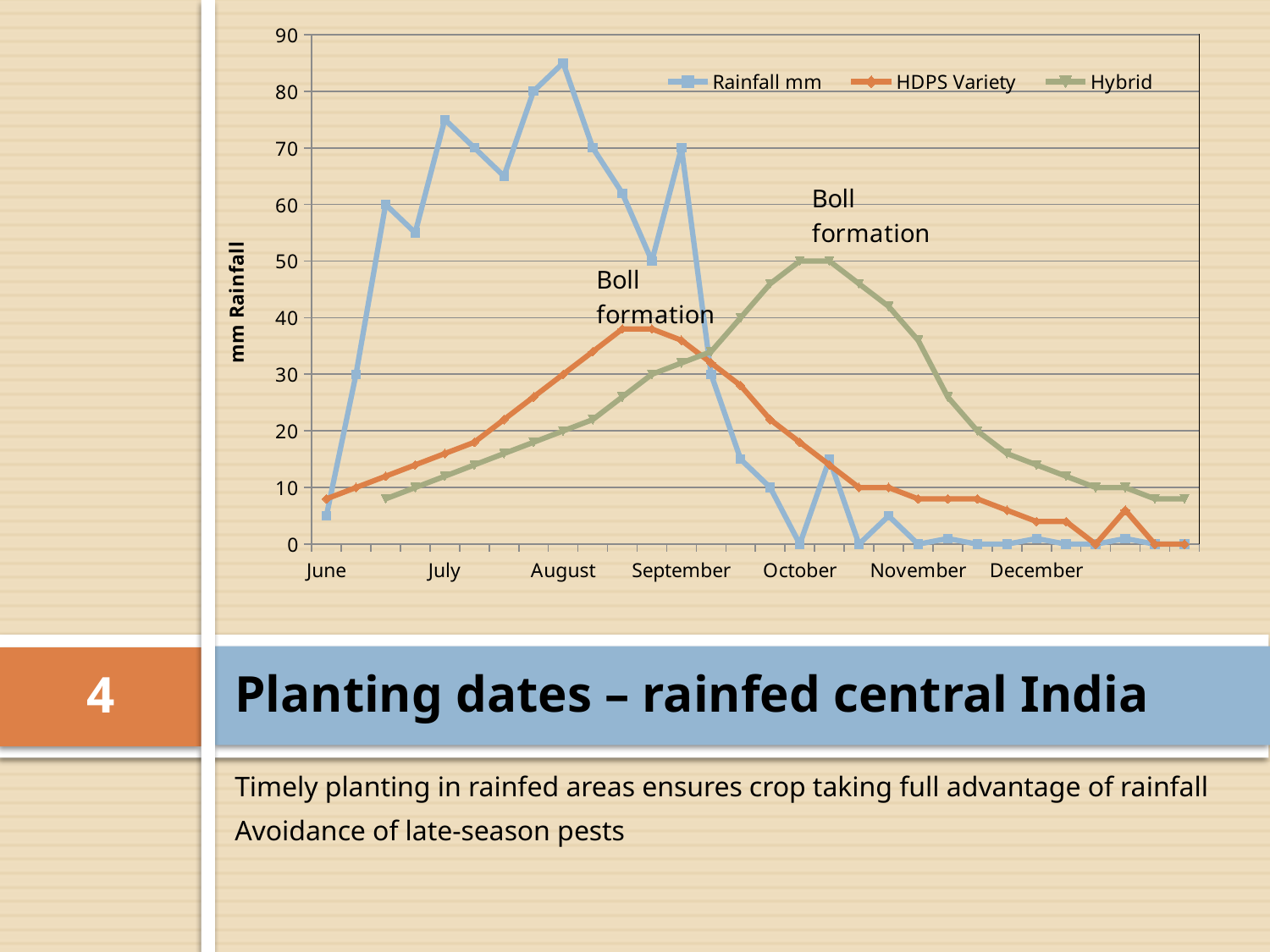
Does the Hybrid line rise or fall between October and December? fall How many series does the legend list? 3 What is the title of the vertical axis? mm Rainfall What are the three series named in the legend? Rainfall mm, HDPS Variety, Hybrid How many month labels are shown along the x axis? 7 Which series reaches a higher peak, HDPS Variety or Hybrid? Hybrid Is the peak value of the Hybrid series greater or less than 40? greater Is the peak value of the Rainfall mm series greater or less than 80? greater Is the Rainfall mm value at June greater or less than 10? less Which series reaches the highest value on the chart? Rainfall mm What kind of chart is shown on the slide? line chart